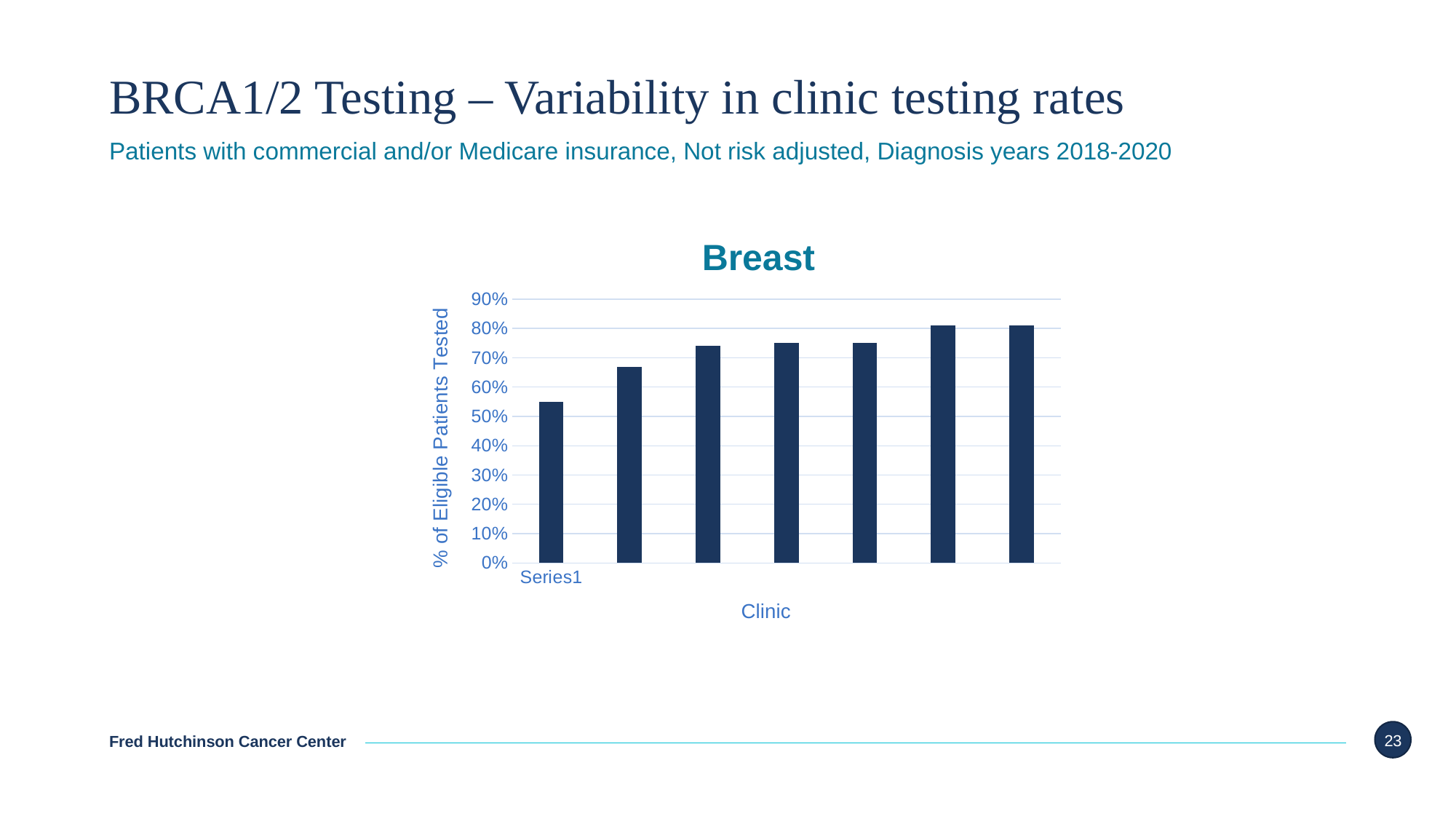
Is the value of the leftmost bar greater or less than 50%? greater How many bars are plotted in the Breast chart? 7 Is the value of the rightmost bar greater or less than 70%? greater Which bar is the lowest in the Breast chart? the leftmost bar Is the value of the third bar from the left greater or less than 80%? less What kind of chart is shown on the slide? bar chart What is the label on the vertical axis of the chart? % of Eligible Patients Tested What is the title of the chart? Breast Do the bar values generally rise or fall from left to right across the chart? rise Which is larger, the leftmost bar or the second bar from the left? the second bar from the left